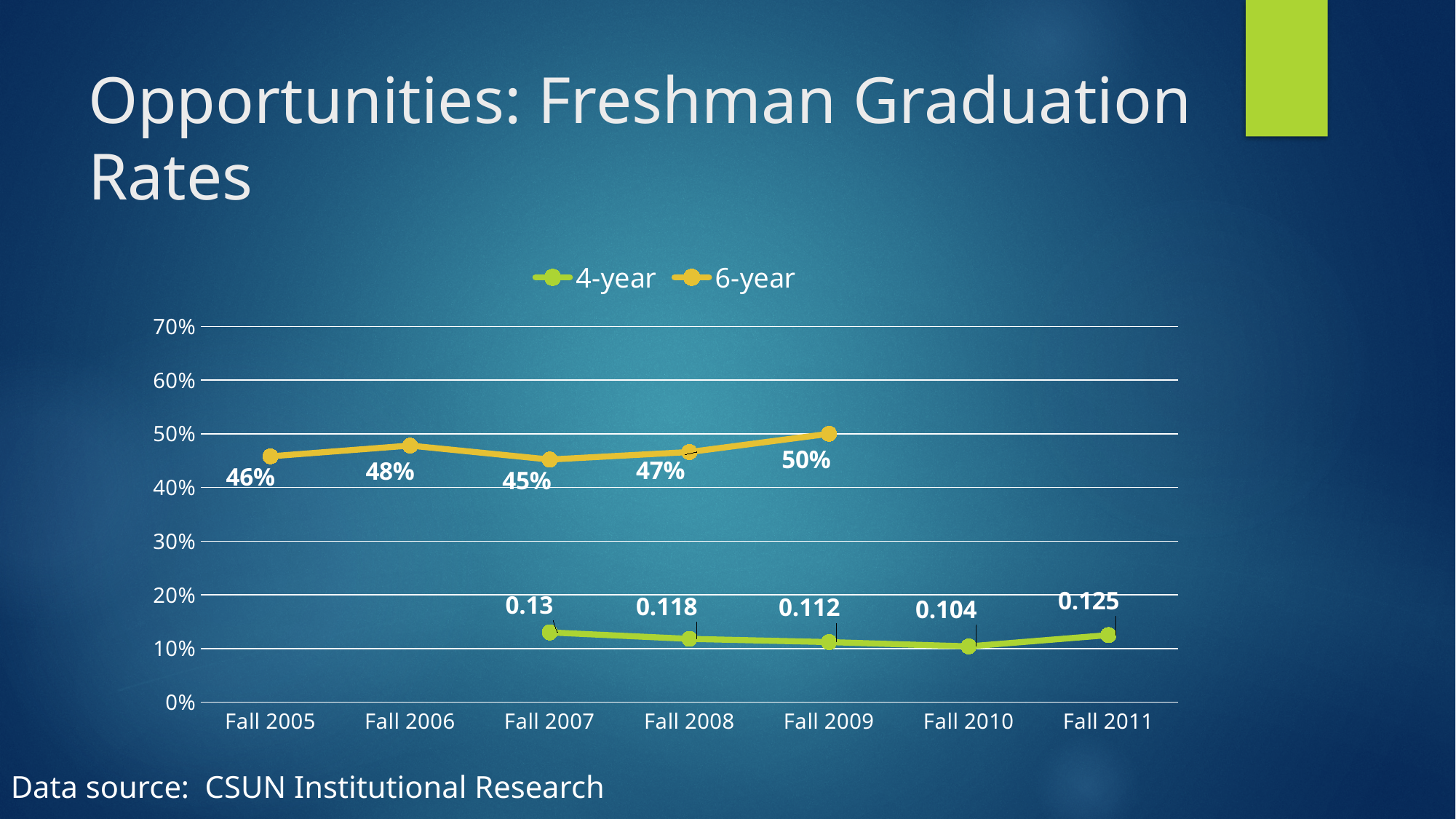
What is the difference between the 6-year rates for Fall 2009 and Fall 2007? 5% Which is larger, the 6-year rate for Fall 2006 or for Fall 2008? Fall 2006 What is the data source named at the bottom of the slide? CSUN Institutional Research How many terms are listed on the x axis? 7 What kind of chart is shown on the slide? Line chart What is the 6-year graduation rate for Fall 2007? 45% What is the 4-year value shown for Fall 2011? 0.125 Which term has the highest 6-year graduation rate? Fall 2009 Which term has the lowest 4-year value? Fall 2010 What is the 4-year value shown for Fall 2010? 0.104 What is the 6-year graduation rate for Fall 2009? 50% How many series does the legend list? 2